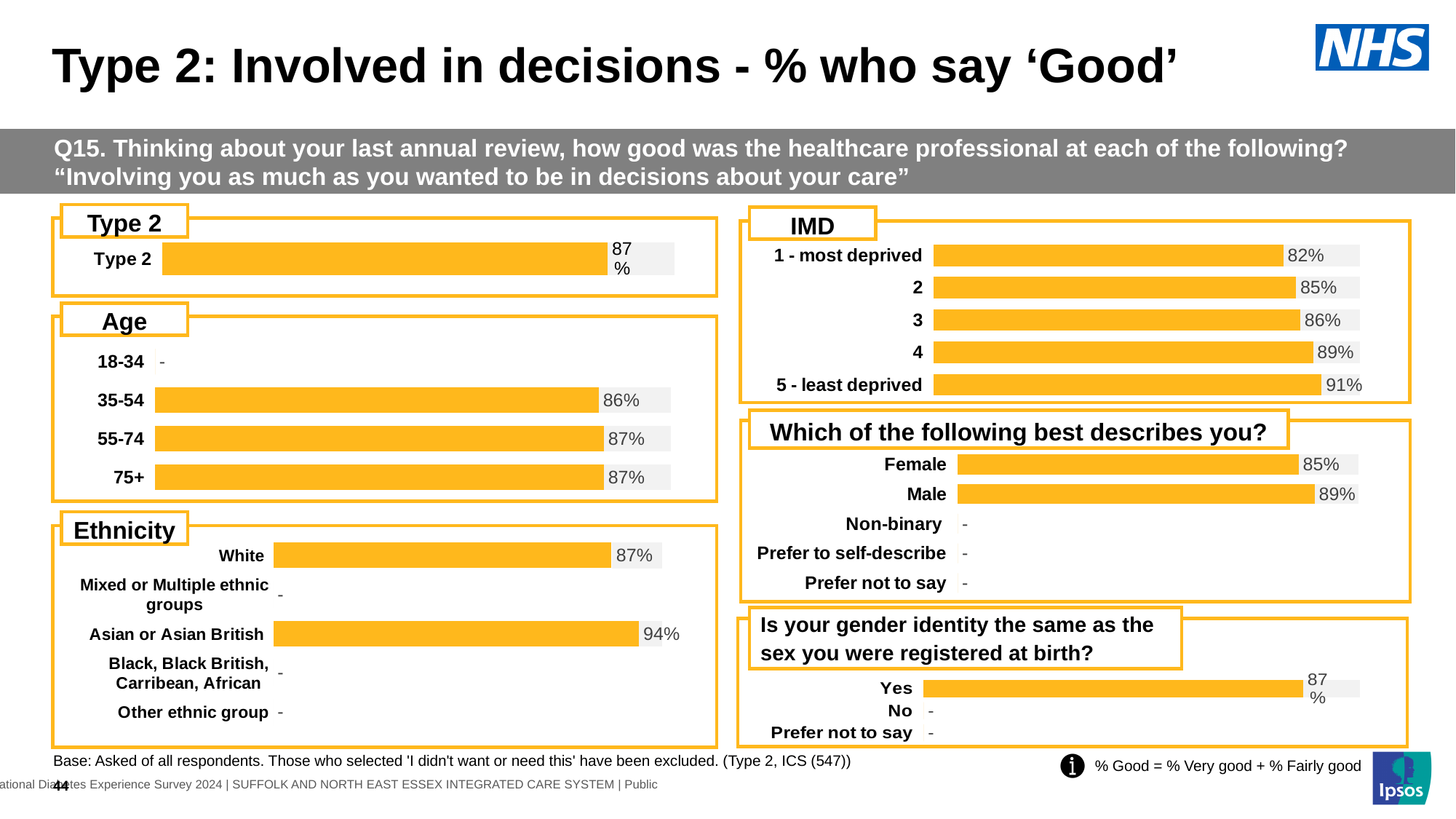
In the Age chart, what is the value for 55-74? 87% In the Ethnicity chart, what is the difference between the values for Asian or Asian British and White? 7 percentage points In the IMD chart, which category has the lowest value? 1 - most deprived In the 'Is your gender identity the same as the sex you were registered at birth?' chart, what is the value for Yes? 87% In the 'Which of the following best describes you?' chart, which is larger, Female or Male? Male In the IMD chart, what is the value for 4? 89% In the Type 2 chart, what is the value for Type 2? 87% In the 'Which of the following best describes you?' chart, what is the difference between Male and Female? 4 percentage points In the Age chart, what is the value for 35-54? 86% In the IMD chart, do the values rise or fall from 1 - most deprived to 5 - least deprived? rise In the IMD chart, which category has the highest value? 5 - least deprived In the Ethnicity chart, what is the value for Asian or Asian British? 94%